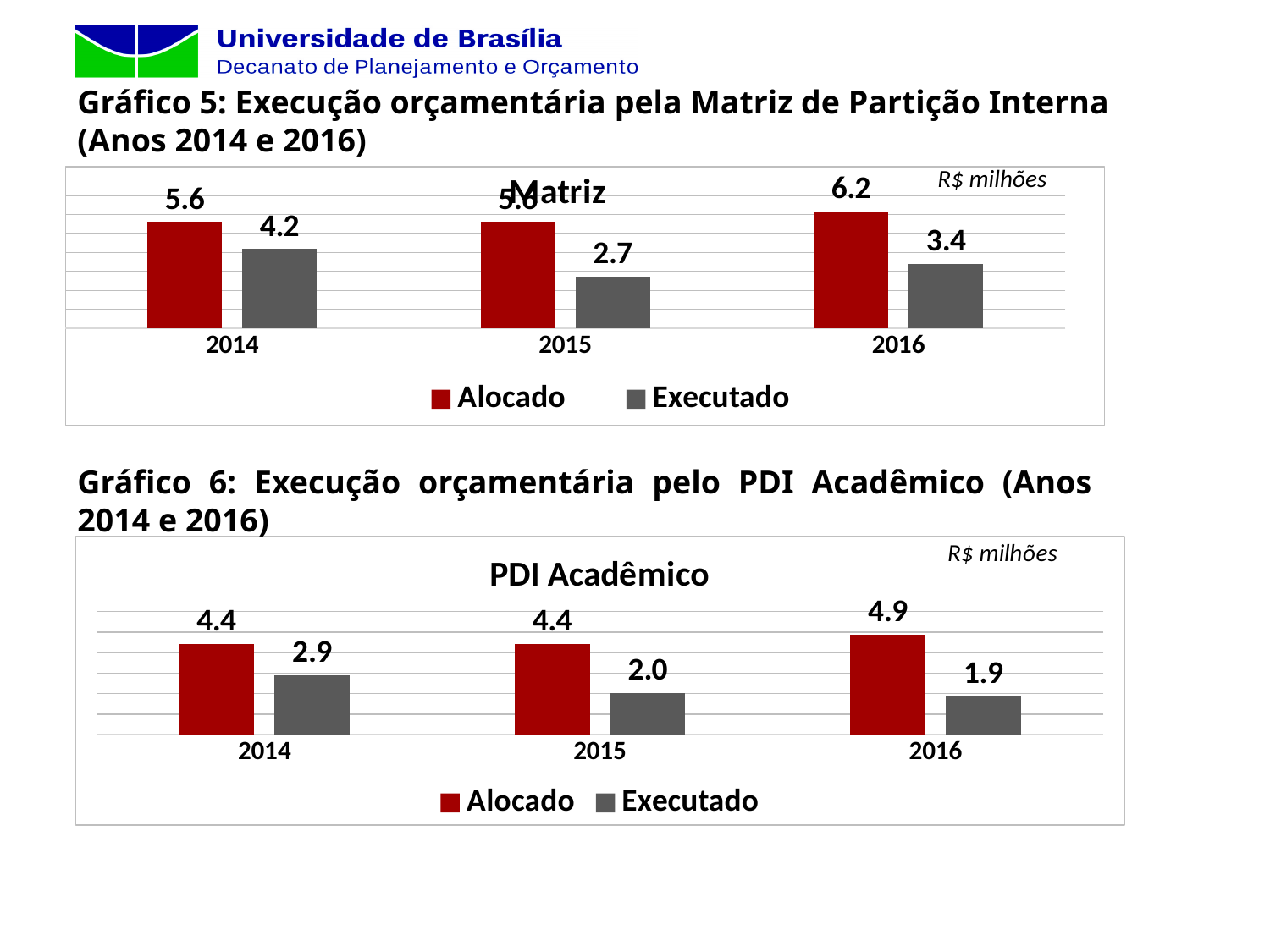
In the Matriz chart, what is the Alocado value for 2014? 5.6 In the Matriz chart, which year has the lowest Executado value? 2015 In the PDI Acadêmico chart, is the Executado value for 2014 larger or smaller than the Executado value for 2016? larger In the PDI Acadêmico chart, which year has the lowest Executado value? 2016 In the Matriz chart, which year has the highest Alocado value? 2016 What type of chart is the Matriz chart? bar chart In the PDI Acadêmico chart, what is the Alocado value for 2016? 4.9 In the Matriz chart, what is the difference between Alocado and Executado in 2016? 2.8 In the Matriz chart, what is the Executado value for 2015? 2.7 In the PDI Acadêmico chart, what is the Executado value for 2014? 2.9 In the PDI Acadêmico chart, what is the difference between Alocado and Executado in 2015? 2.4 How many series does the legend of the PDI Acadêmico chart list? 2